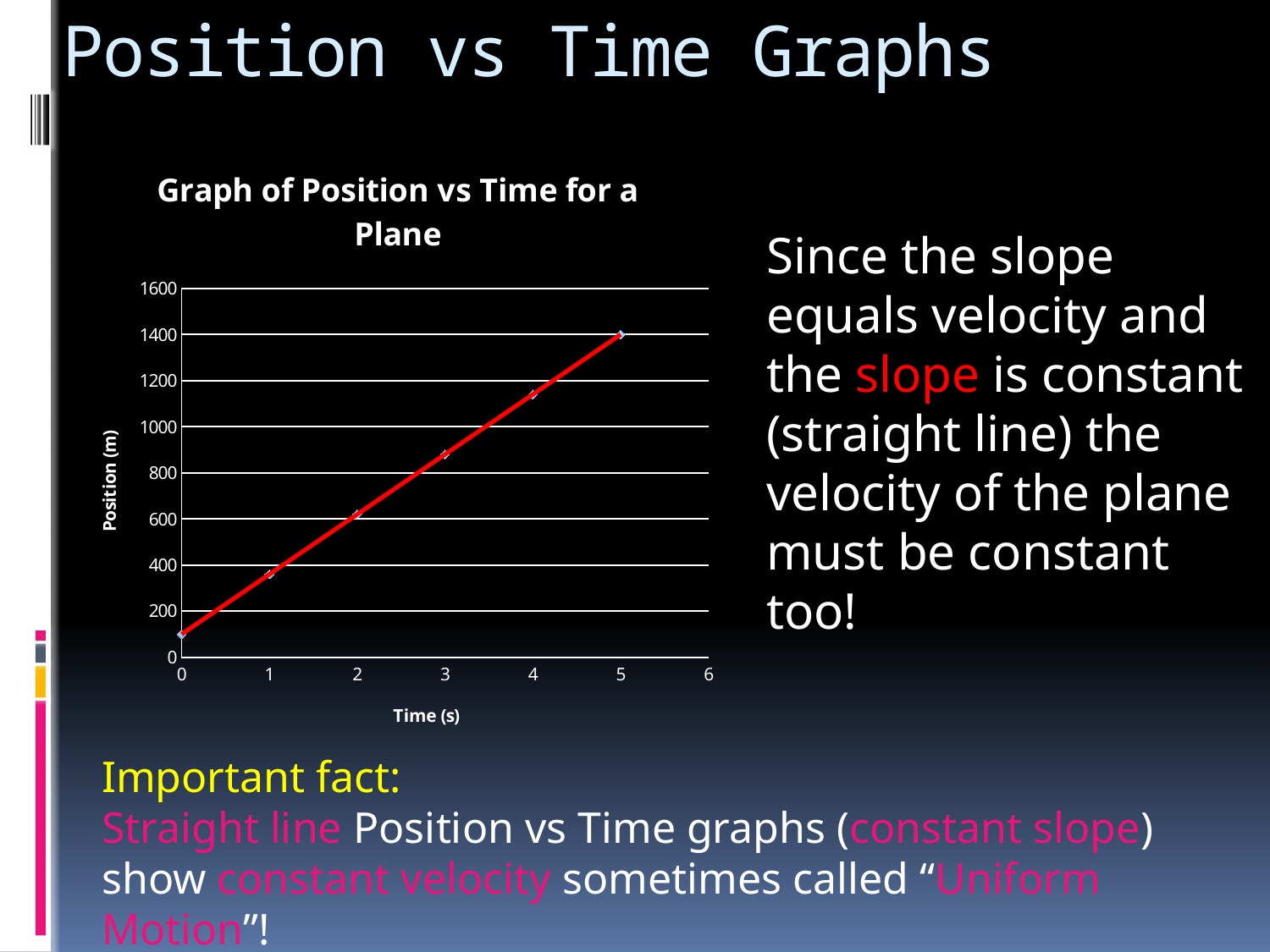
Is the position at a time of 0 s greater or less than 200? less What kind of chart is shown on the slide? line chart Which is larger, the position at 2 s or the position at 4 s? 4 s Is the position at a time of 3 s greater or less than 800? greater What is the title of the chart? Graph of Position vs Time for a Plane Is the position at a time of 1 s greater or less than 400? less What is the label of the vertical axis? Position (m) Do the plotted values rise or fall as time increases? rise What is the position at a time of 5 s? 1400 At which time is the plotted position highest? 5 How many data points are plotted on the line? 6